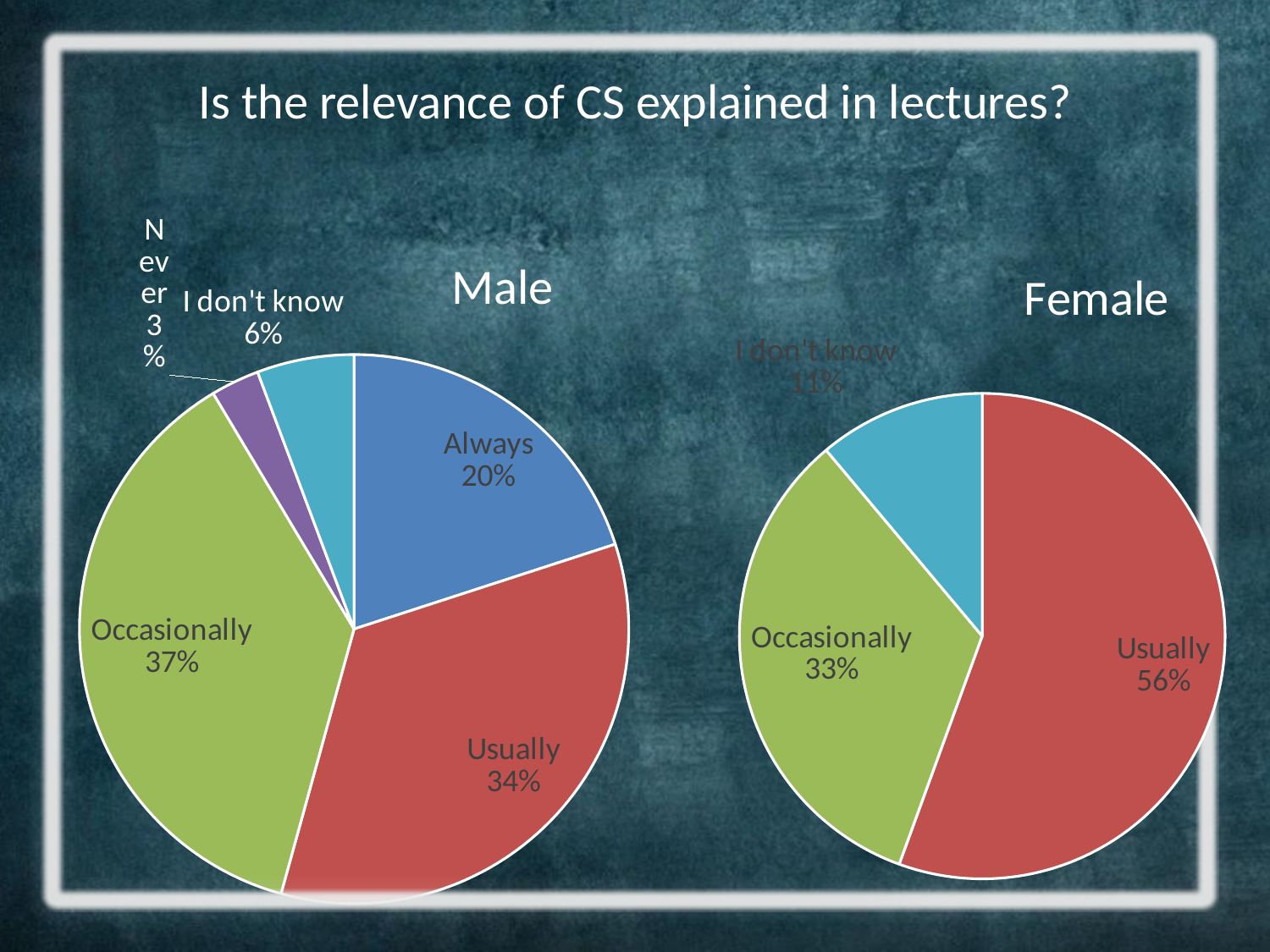
In the Male chart, what share of responses is "Always"? 20% In the Male chart, which category has the smallest slice? Never In the Male chart, what share of responses is "Never"? 3% In the Male chart, what share of responses is "Occasionally"? 37% How many slices does the Female chart have? 3 In the Female chart, which category has the smallest slice? I don't know What is the difference between the "Usually" share in the Female chart and the "Usually" share in the Male chart? 22% What kind of chart is the Male chart? pie chart How many slices does the Male chart have? 5 In the Male chart, which category has the largest slice? Occasionally In the Female chart, what share of responses is "I don't know"? 11% In the Female chart, what share of responses is "Usually"? 56%